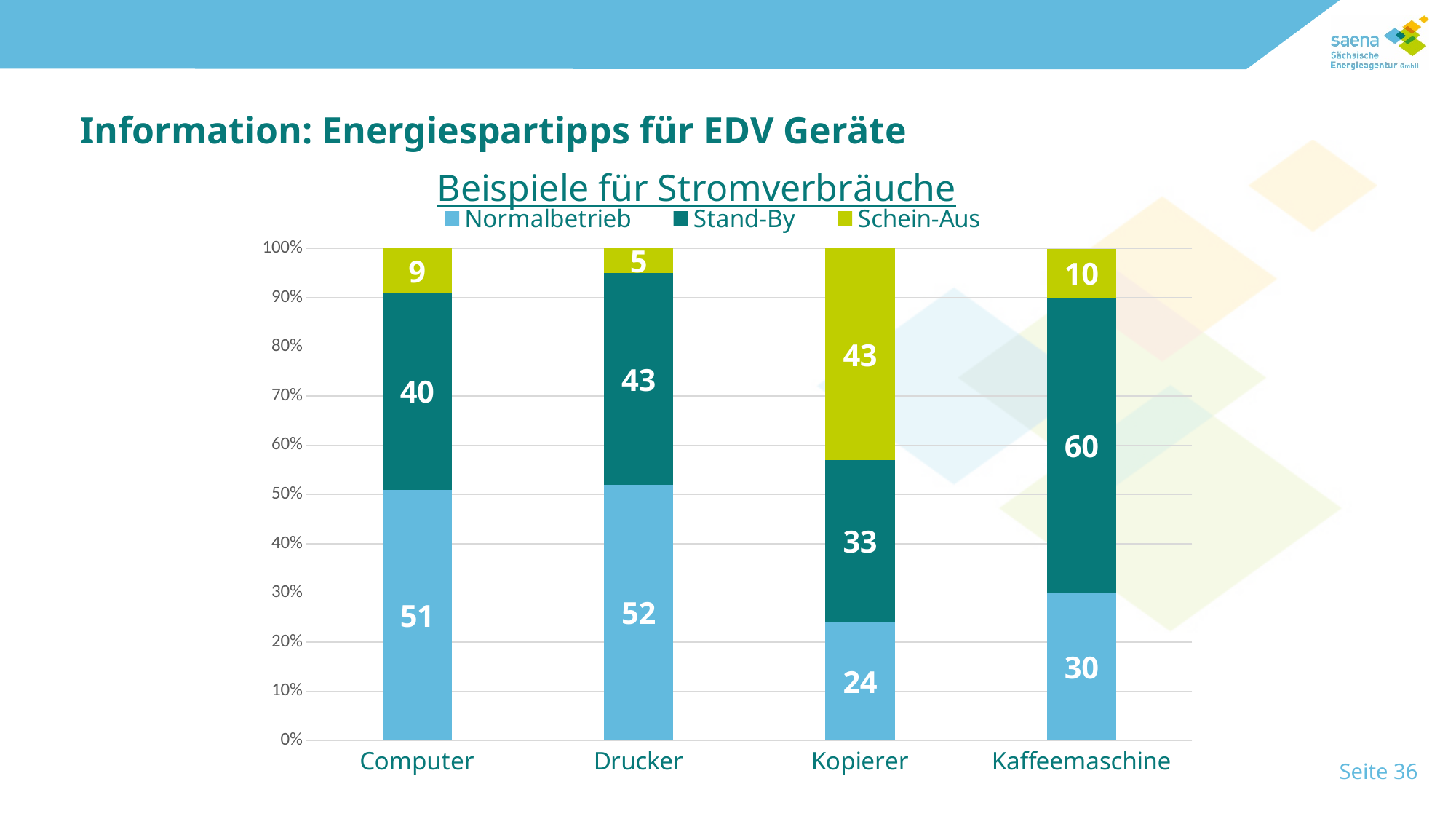
How many series does the legend list? 3 Which category has the lowest Normalbetrieb value? Kopierer Which category has the highest Stand-By value? Kaffeemaschine What is the title of the chart? Beispiele für Stromverbräuche What kind of chart is shown? Stacked bar chart What is the difference between the Stand-By values for Drucker and Computer? 3 What is the Schein-Aus value for Drucker? 5 What is the Schein-Aus value for Kopierer? 43 Which is larger, the Schein-Aus value for Kaffeemaschine or for Computer? Kaffeemaschine What is the Stand-By value for Kaffeemaschine? 60 What is the Normalbetrieb value for Computer? 51 How many categories are shown on the x axis? 4